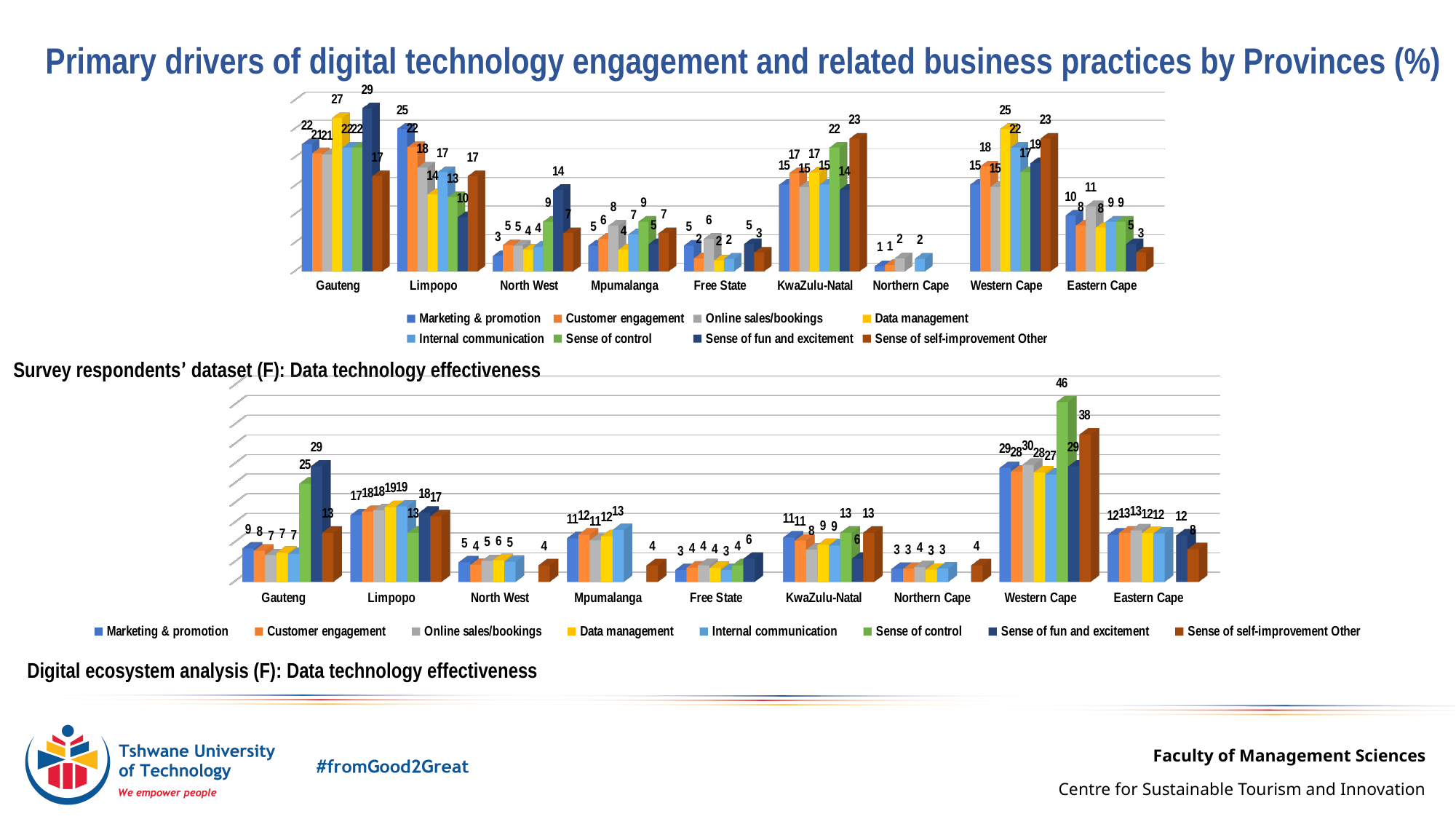
What kind of chart is the top chart (Survey respondents' dataset)? Bar chart In the top chart (Survey respondents' dataset), what is the value for Sense of self-improvement Other in KwaZulu-Natal? 23 In the bottom chart (Digital ecosystem analysis), what is the value for Sense of control in Gauteng? 25 In the top chart (Survey respondents' dataset), what is the value for Sense of fun and excitement in Gauteng? 29 In the bottom chart (Digital ecosystem analysis), what is the value for Sense of control in Western Cape? 46 In the top chart (Survey respondents' dataset), which is larger in Gauteng: Sense of fun and excitement or Data management? Sense of fun and excitement In the top chart (Survey respondents' dataset), what is the value for Marketing & promotion in Limpopo? 25 How many provinces are shown on the x axis of the top chart (Survey respondents' dataset)? 9 In the bottom chart (Digital ecosystem analysis), which province has the highest single bar? Western Cape In the bottom chart (Digital ecosystem analysis), what is the difference between Sense of control and Sense of self-improvement Other in Western Cape? 8 How many series does the legend of the bottom chart (Digital ecosystem analysis) list? 8 In the bottom chart (Digital ecosystem analysis), what is the value for Sense of self-improvement Other in Western Cape? 38